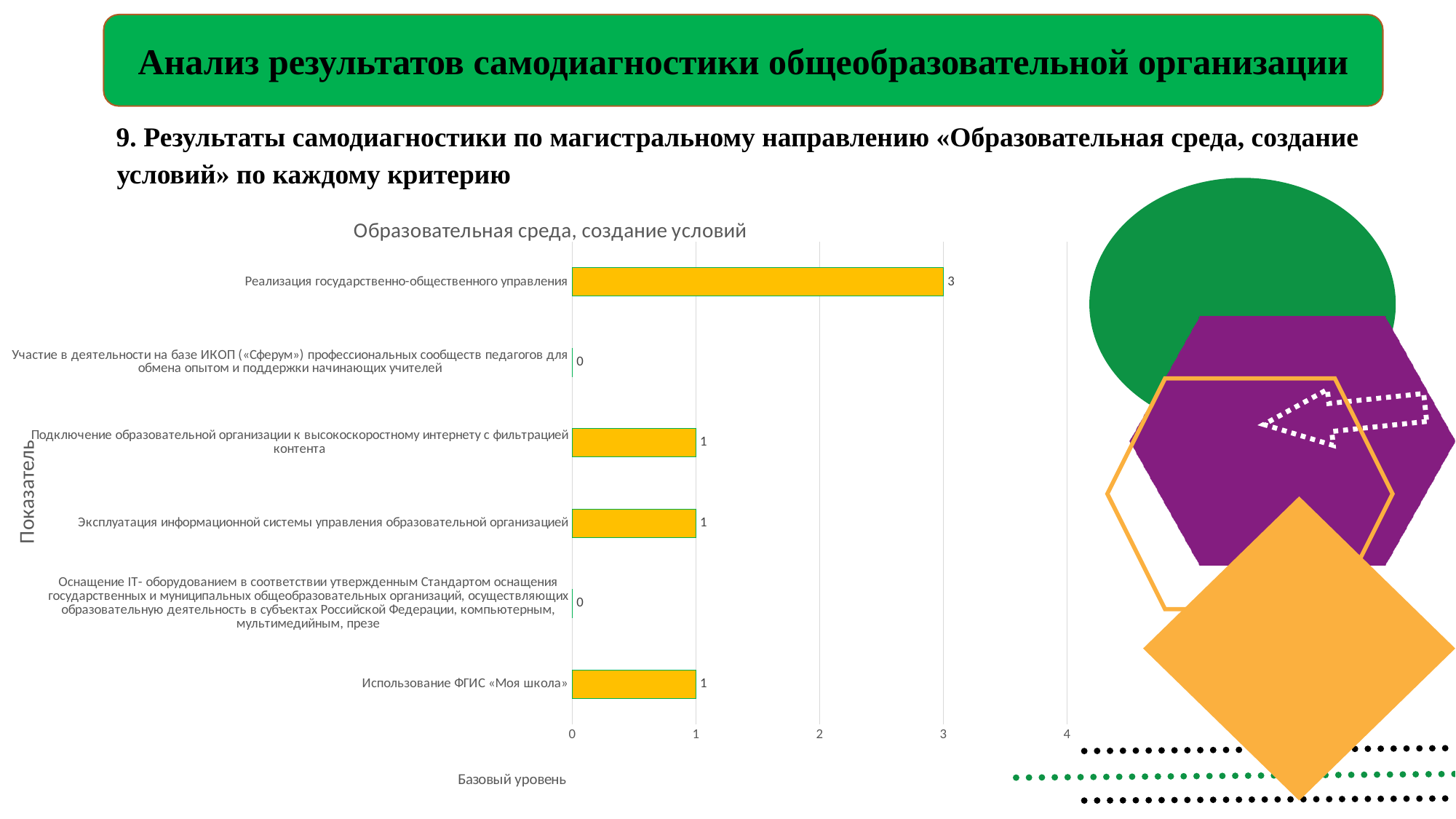
How many categories are shown in the chart? 6 What is the label on the horizontal axis of the chart? Базовый уровень What is the difference between the value for «Реализация государственно-общественного управления» and the value for «Подключение образовательной организации к высокоскоростному интернету с фильтрацией контента»? 2 How many categories have a value of 0? 2 What is the value for «Реализация государственно-общественного управления»? 3 Which is larger: the value for «Реализация государственно-общественного управления» or the value for «Использование ФГИС «Моя школа»»? Реализация государственно-общественного управления What is the title of the chart? Образовательная среда, создание условий What is the value for «Участие в деятельности на базе ИКОП («Сферум») профессиональных сообществ педагогов для обмена опытом и поддержки начинающих учителей»? 0 What is the value for «Эксплуатация информационной системы управления образовательной организацией»? 1 What is the value for «Использование ФГИС «Моя школа»»? 1 Which category has the highest value? Реализация государственно-общественного управления What type of chart is shown on the slide? bar chart